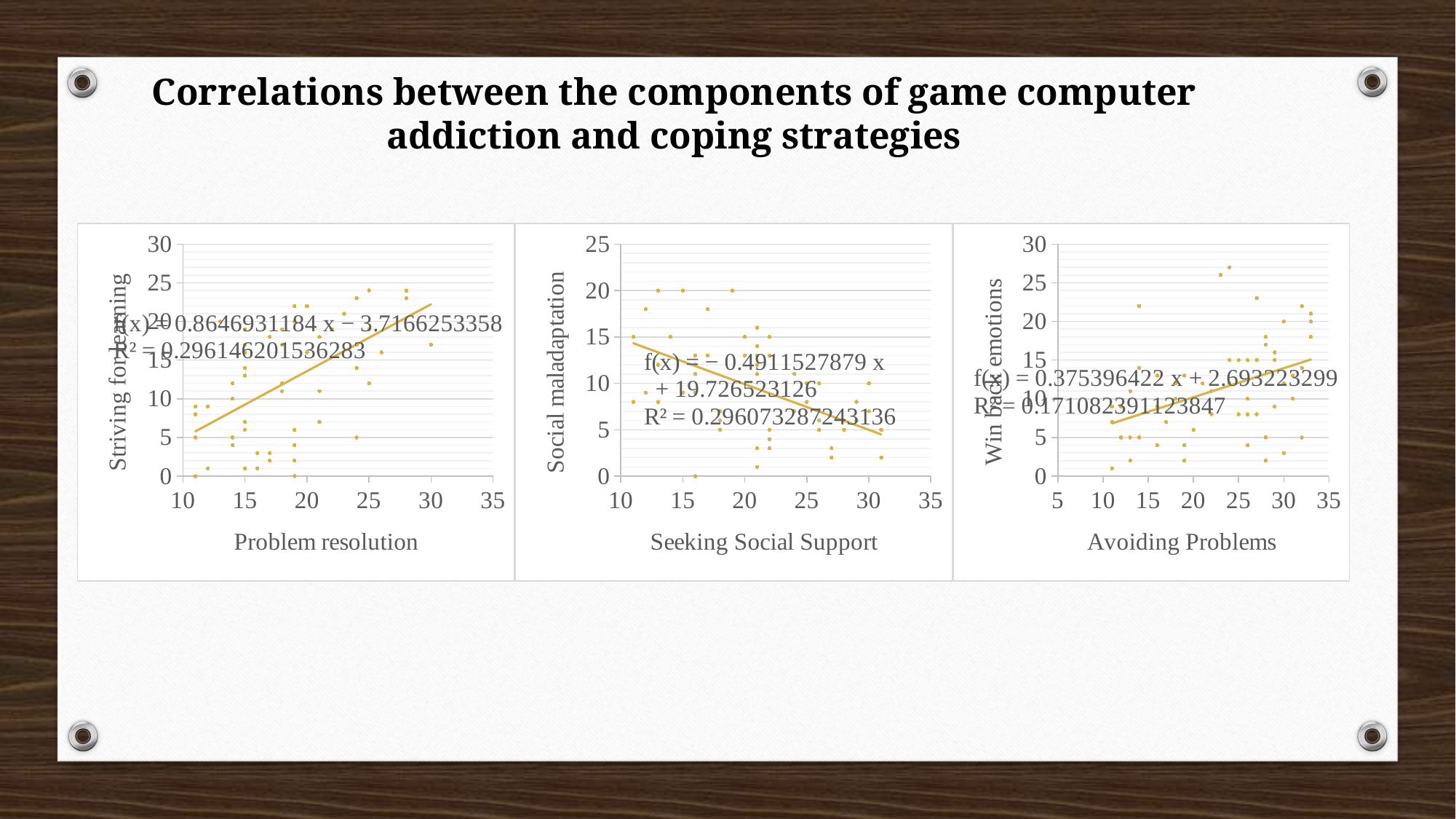
What is the R² value printed on the left chart (Problem resolution)? 0.296146201536283 What is the slope of the trendline equation printed on the middle chart (Seeking Social Support)? − 0.4911527879 What is the y-axis title of the middle chart (Seeking Social Support)? Social maladaptation What is the y-axis title of the right chart (Avoiding Problems)? Win back emotions What is the R² value printed on the right chart (Avoiding Problems)? 0.171082391123847 In the middle chart (Seeking Social Support), does the trendline rise or fall as Seeking Social Support increases? fall What kind of chart is the left chart, titled 'Problem resolution' on its x axis? scatter chart In the right chart (Avoiding Problems), does the trendline rise or fall as Avoiding Problems increases? rise What is the R² value printed on the middle chart (Seeking Social Support)? 0.296073287243136 In the left chart (Problem resolution), does the trendline rise or fall as Problem resolution increases? rise How many charts are shown on the slide? 3 What is the highest tick value on the y axis of the middle chart (Seeking Social Support)? 25